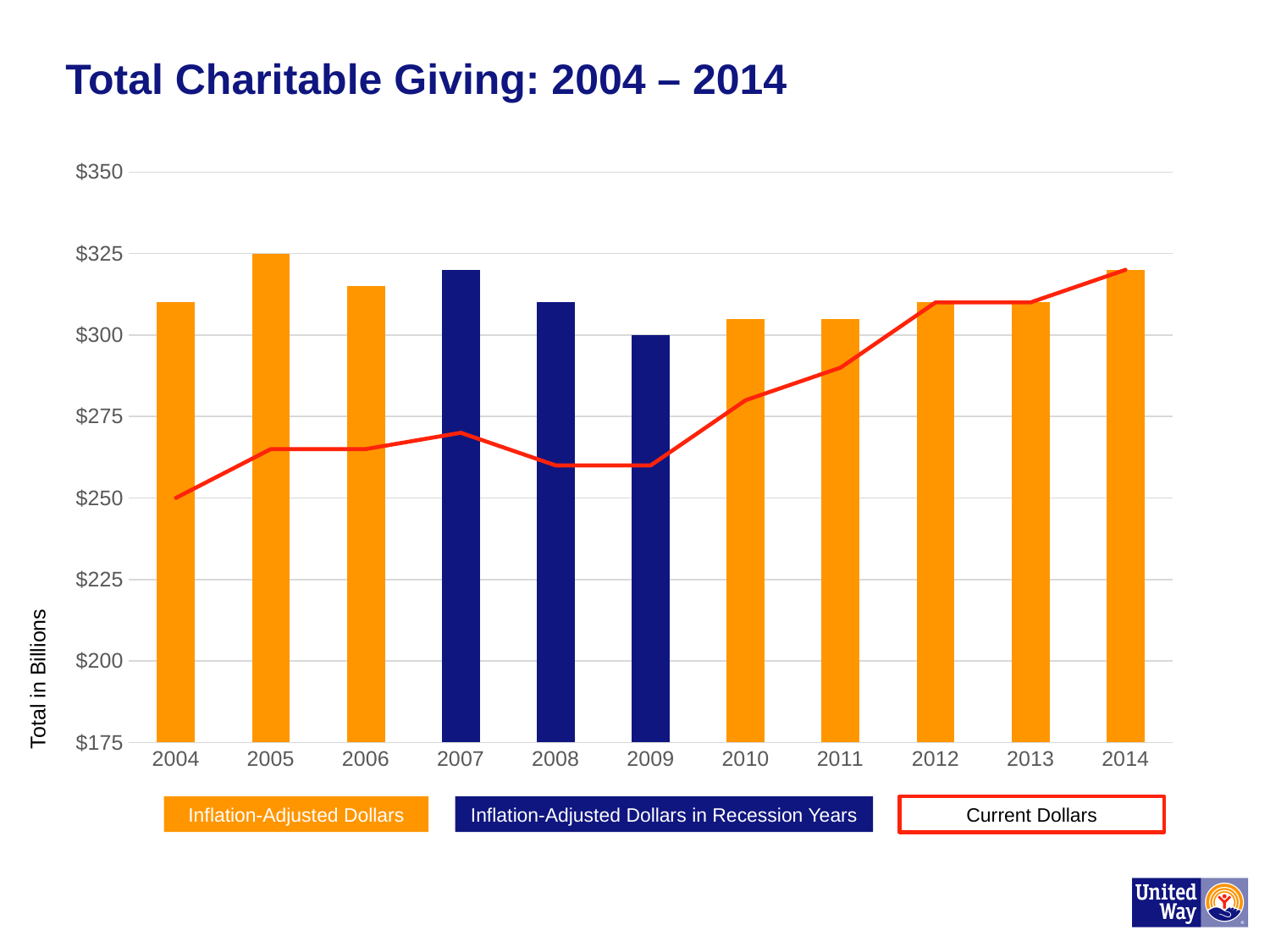
How many series does the legend list? 3 In which year is the Current Dollars line at its lowest? 2004 How many years are shown on the x axis of the chart? 11 In which year is the Current Dollars line at its highest? 2014 Does the Current Dollars line rise or fall from 2010 to 2014? rise Which years are shown as Inflation-Adjusted Dollars in Recession Years (dark blue bars)? 2007, 2008, 2009 Is the Current Dollars value for 2010 greater or less than $300? less Which year has the lowest inflation-adjusted dollars bar? 2009 What is the title of the chart? Total Charitable Giving: 2004 – 2014 What kind of chart is shown on the slide? A bar chart with a line overlay Is the Current Dollars value for 2008 greater or less than $275? less Is the inflation-adjusted dollars bar for 2004 greater or less than $300? greater